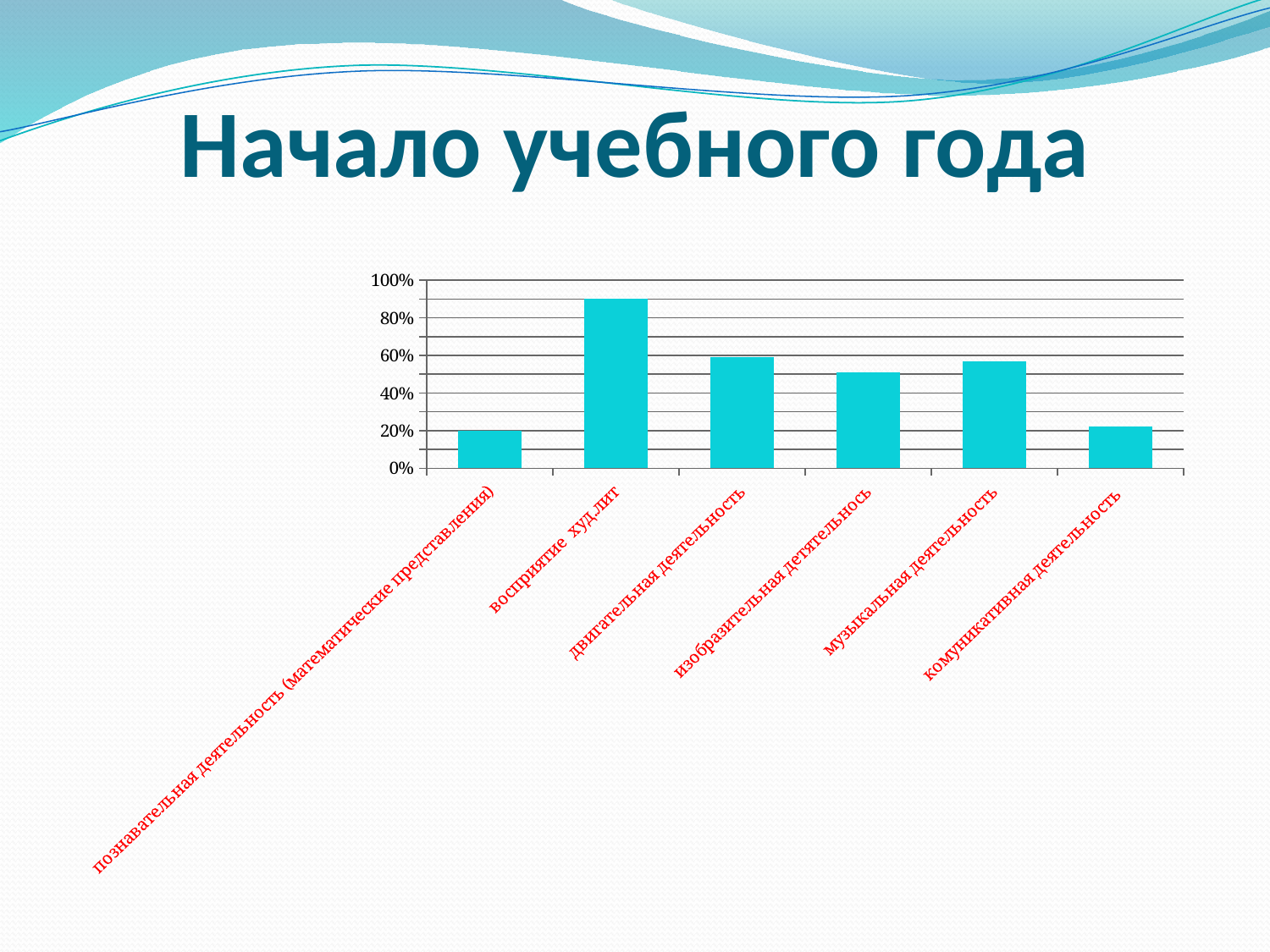
Is the value for познавательная деятельность (математические представления) greater or less than 40%? less Is the value for изобразительная деятельность greater or less than 40%? greater How many categories are plotted on the chart? 6 Is the value for изобразительная деятельность greater or less than 60%? less Which is larger, the value for двигательная деятельность or the value for изобразительная деятельность? двигательная деятельность Which category has the highest bar? восприятие худ.лит Which is larger, the value for восприятие худ.лит or the value for двигательная деятельность? восприятие худ.лит What kind of chart is shown on the slide? bar chart What is the title of the slide containing the chart? Начало учебного года